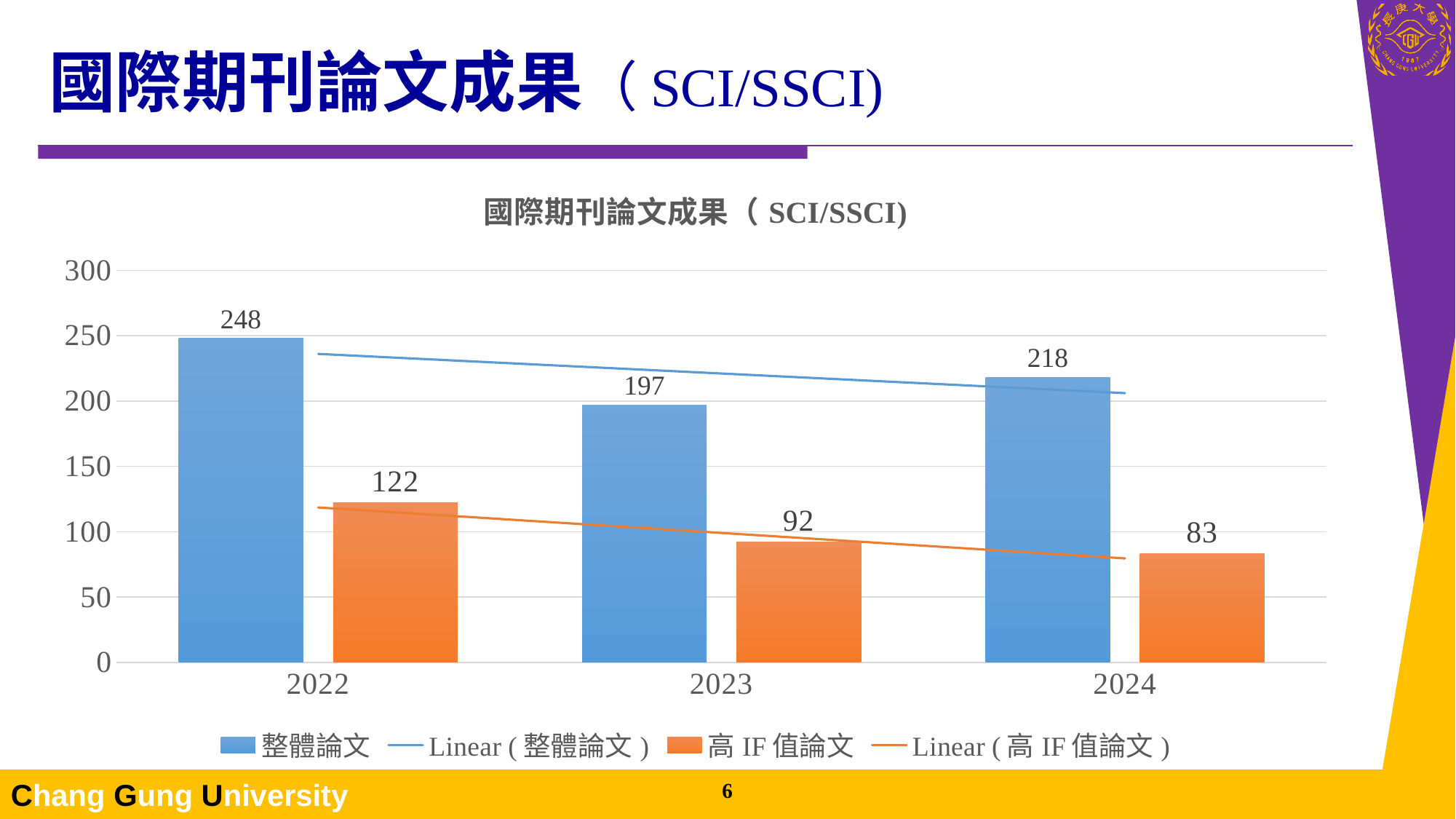
What is the value of 高 IF 值論文 for 2024? 83 What is the value of 整體論文 for 2023? 197 Which is larger: 整體論文 in 2024 or 整體論文 in 2023? 整體論文 in 2024 How many entries does the legend list? 4 Which year has the highest value for 整體論文? 2022 What is the difference between 整體論文 and 高 IF 值論文 in 2023? 105 Which year has the lowest value for 高 IF 值論文? 2024 Is the value of 高 IF 值論文 for 2022 greater or less than 100? greater Does the value of 高 IF 值論文 rise or fall from 2022 to 2024? Fall What is the value of 整體論文 for 2022? 248 What kind of chart is this? Bar chart How many years are shown on the x axis? 3